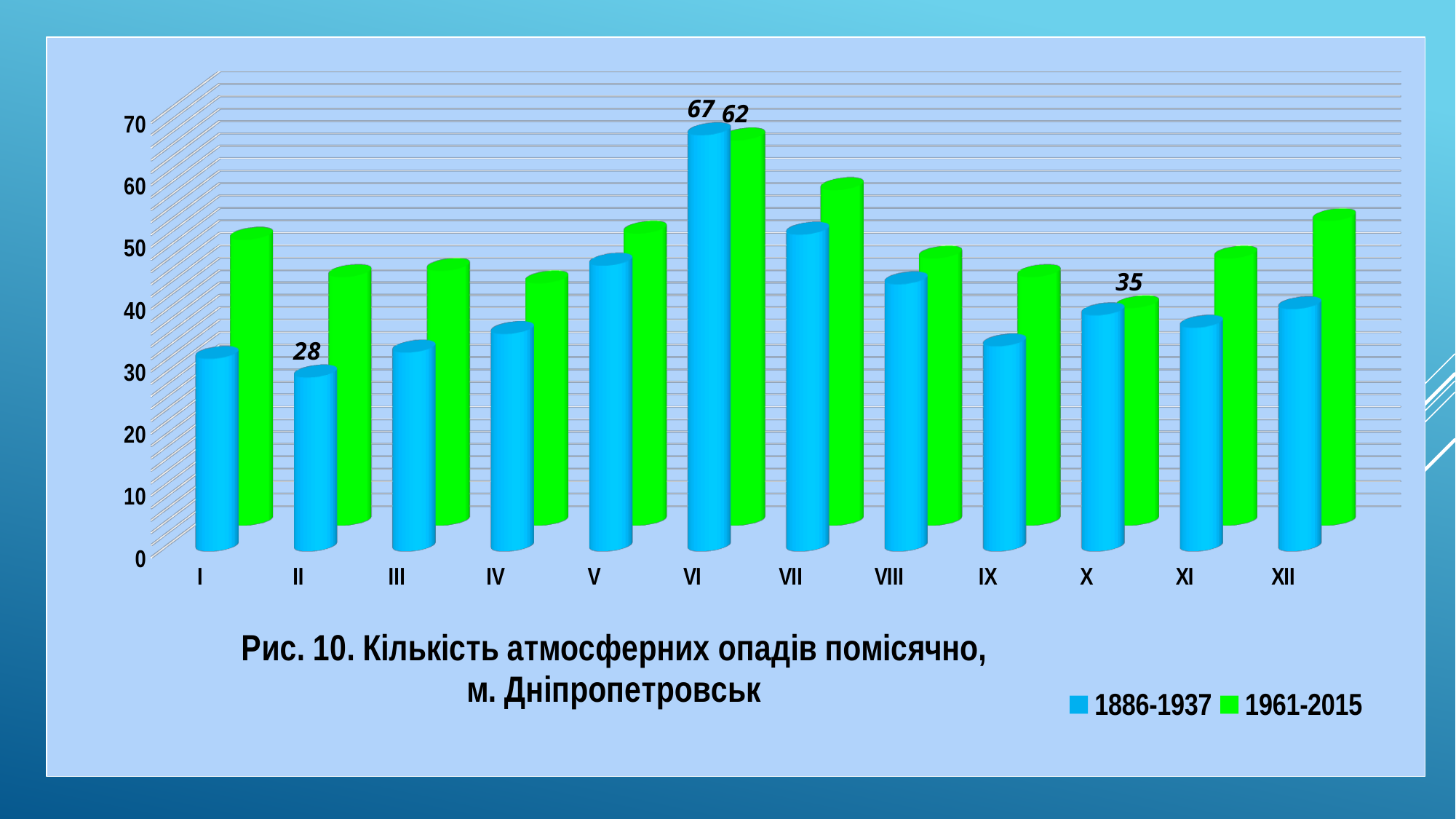
What is the value for month VI in the 1886-1937 series? 67 What is the difference between the 1886-1937 and 1961-2015 values for month VI? 5 What is the value for month X in the 1961-2015 series? 35 Is the 1961-2015 value for month VII greater or less than 50? greater What kind of chart is shown on the slide? bar chart Which month has the lowest value in the 1886-1937 series? II For month I, which series has the larger value, 1886-1937 or 1961-2015? 1961-2015 How many series does the legend list? 2 How many months are shown on the x axis? 12 Which month has the highest value in the 1886-1937 series? VI What is the value for month VI in the 1961-2015 series? 62 What is the value for month II in the 1886-1937 series? 28